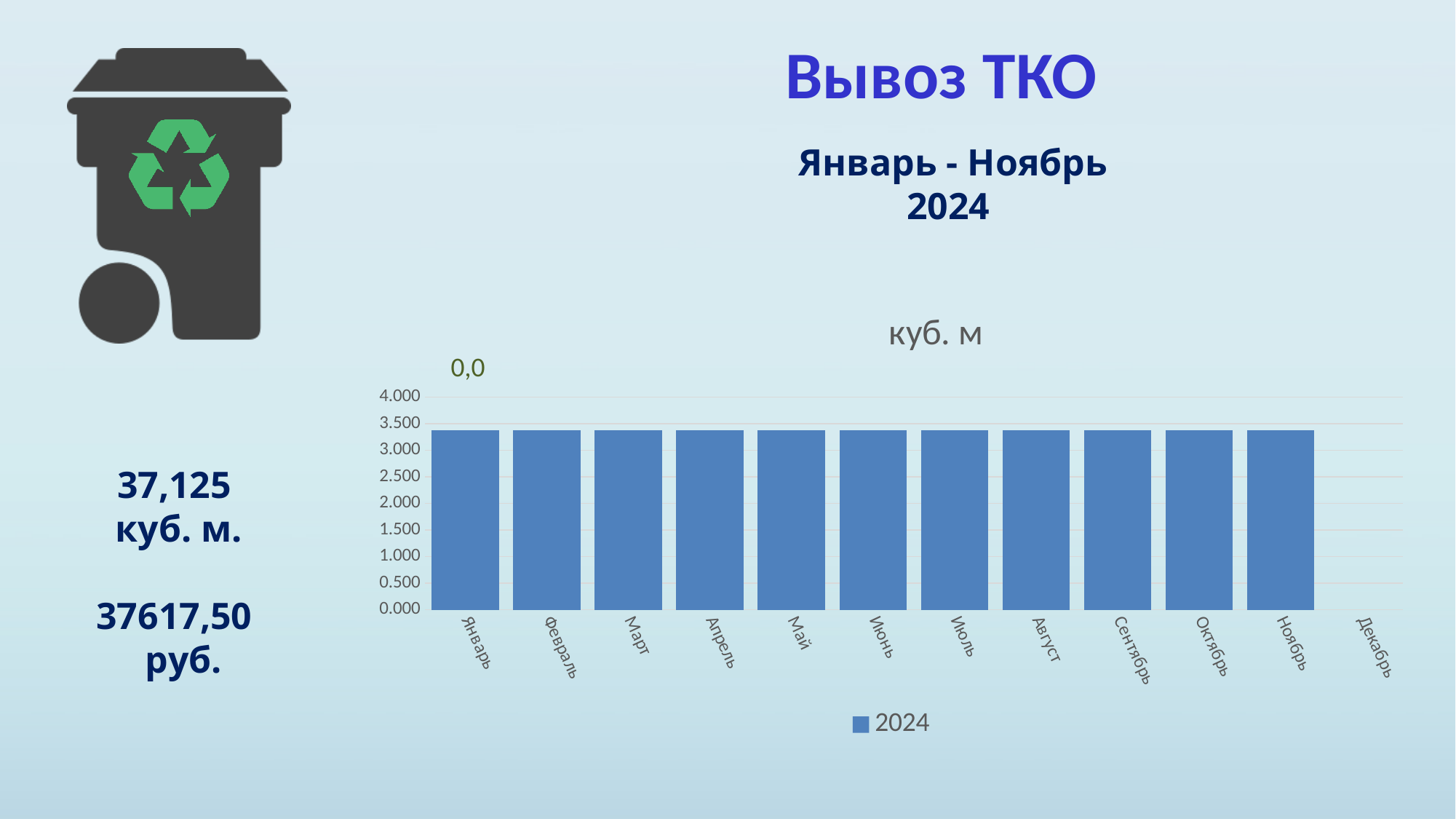
Is the value for Январь greater or less than 3.000? greater Is the value for Май greater or less than 3.500? less Is the value for Сентябрь greater or less than 1.000? greater What kind of chart is shown on the slide? bar chart Do the bar values rise, fall, or stay roughly flat from Январь to Ноябрь? stay roughly flat How many series does the chart legend list? 1 Which month on the x axis has no bar plotted? Декабрь How many month categories are shown on the x axis of the chart? 12 What is the title of the chart? куб. м What is the name of the series in the chart legend? 2024